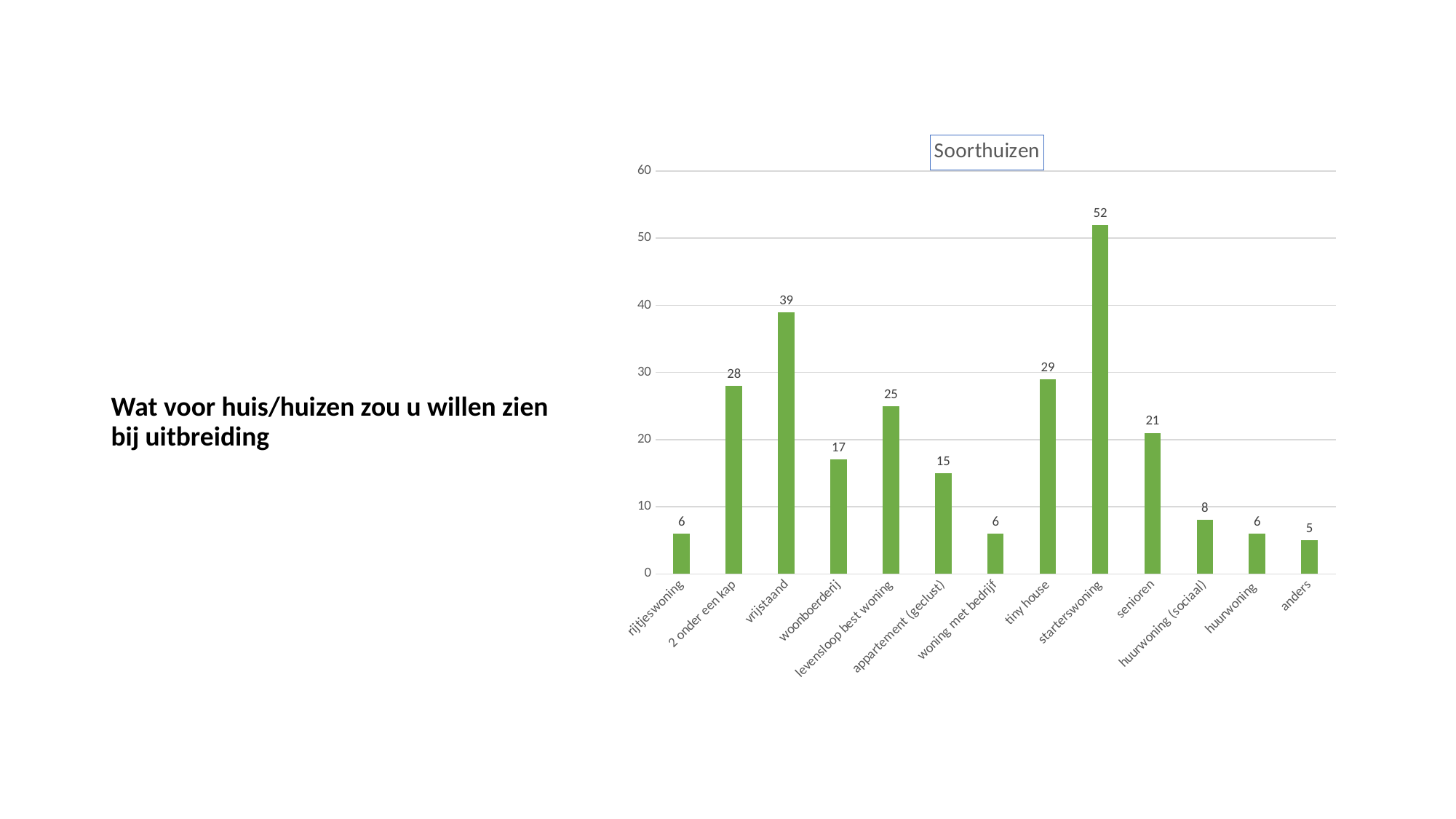
What is the value for huurwoning (sociaal)? 8 Which category has the highest value? starterswoning What is the value for levensloop best woning? 25 What is the value for vrijstaand? 39 What is the value for starterswoning? 52 What kind of chart is shown on the slide? bar chart Which category has the lowest value? anders What is the difference between the values for senioren and woonboerderij? 4 Which is larger, the value for tiny house or the value for 2 onder een kap? tiny house What is the difference between the values for starterswoning and vrijstaand? 13 How many categories are shown on the x axis? 13 What is the title of the chart? Soorthuizen